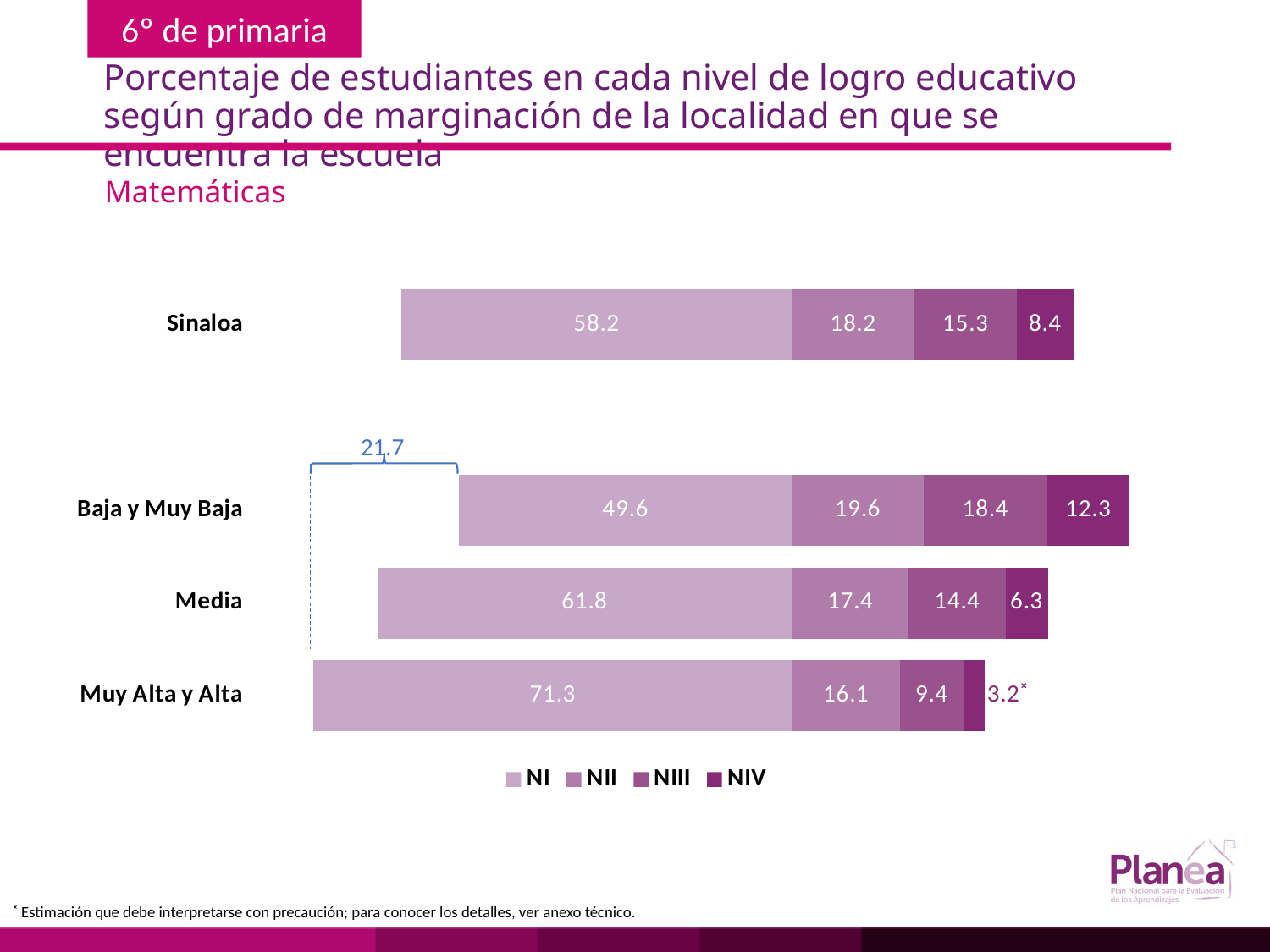
What is the NI value for Sinaloa? 58.2 Which is larger, the NIII value for Sinaloa or the NIII value for Media? Sinaloa What is the NIV value for Baja y Muy Baja? 12.3 What is the total of the stacked bar for Sinaloa? 100.1 How many categories are shown in the chart? 4 How many series does the legend list? 4 What is the NIII value for Muy Alta y Alta? 9.4 What is the NII value for Media? 17.4 What is the difference between the NI value for Muy Alta y Alta and the NI value for Baja y Muy Baja? 21.7 Which category has the lowest NIV value? Muy Alta y Alta What type of chart is shown on the slide? Stacked bar chart Which category has the highest NI value? Muy Alta y Alta